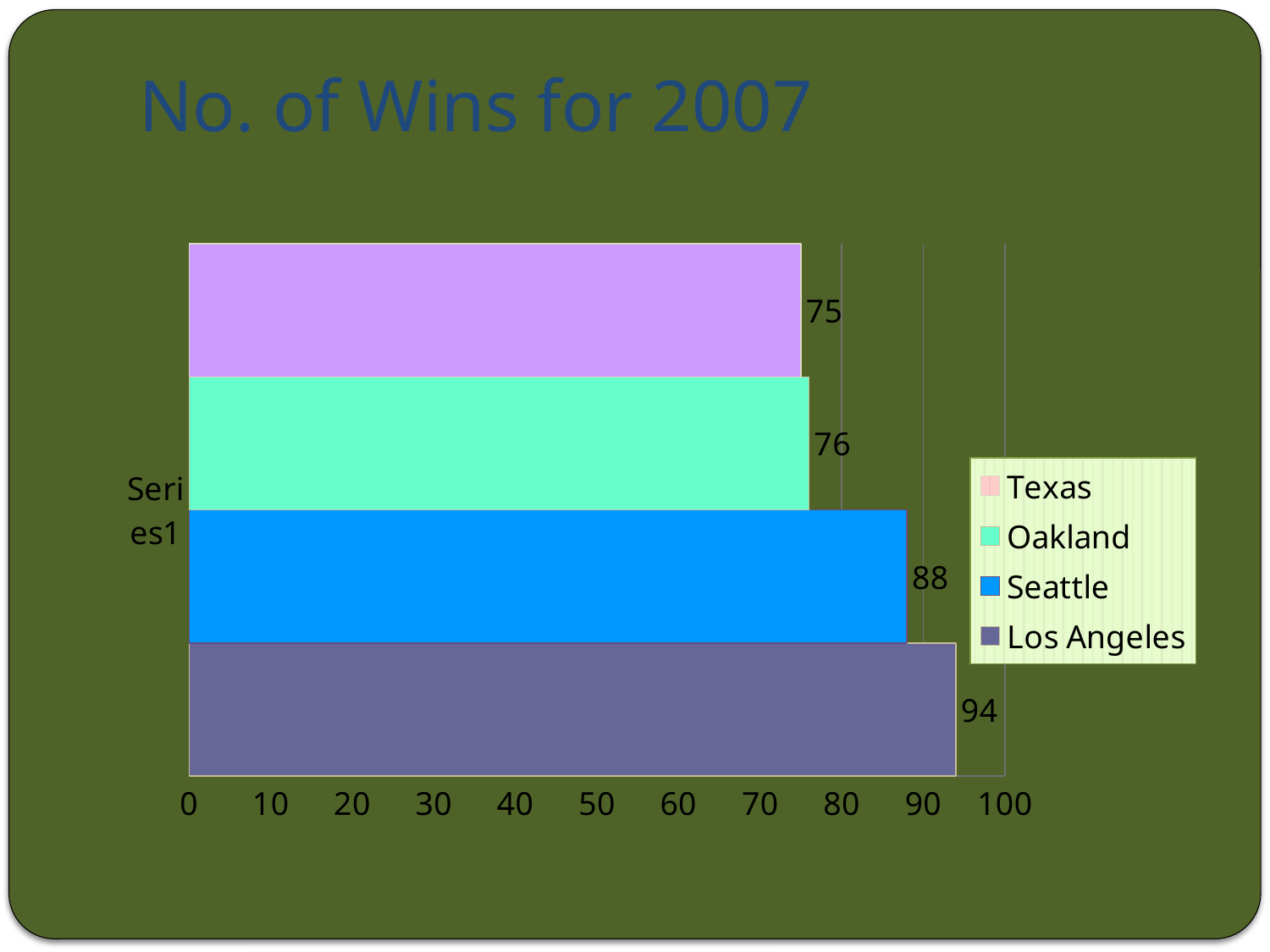
What is the title of the chart? No. of Wins for 2007 How many teams are shown in the chart? 4 Which team has the lowest number of wins? Texas What is the number of wins for Seattle? 88 What is the difference in wins between Seattle and Oakland? 12 What is the number of wins for Texas? 75 What is the number of wins for Los Angeles? 94 What is the number of wins for Oakland? 76 What kind of chart is shown on the slide? Bar chart What is the difference in wins between Los Angeles and Seattle? 6 Which team has the highest number of wins? Los Angeles Which has more wins, Seattle or Oakland? Seattle